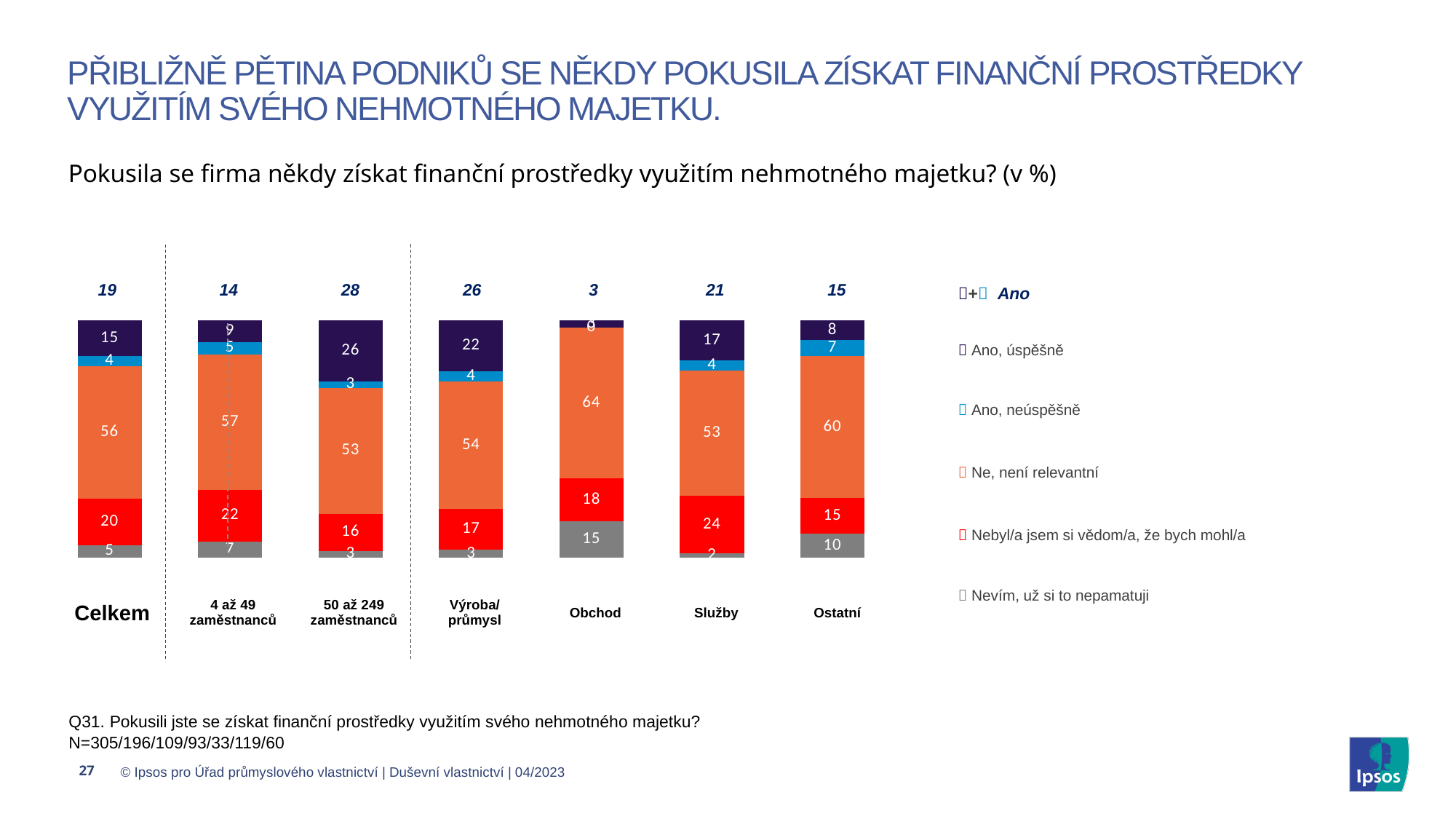
Which colour represents 'Ne, není relevantní' in the chart? orange What is the combined 'Ano' value shown above the Obchod bar? 3 Which category has the highest combined 'Ano' value shown above the bars? 50 až 249 zaměstnanců Which has a larger 'Nebyl/a jsem si vědom/a, že bych mohl/a' value: Služby or Ostatní? Služby What kind of chart is shown on the slide? stacked bar chart What is the value of 'Nevím, už si to nepamatuji' for Ostatní? 10 What is the value of 'Ano, úspěšně' for 50 až 249 zaměstnanců? 26 What is the value of 'Ne, není relevantní' for Celkem? 56 What is the difference between the 'Ne, není relevantní' values for Obchod and Celkem? 8 How many response categories does the legend list (excluding the combined 'Ano' line)? 5 How many categories (bars) are shown in the chart? 7 Which category has the lowest combined 'Ano' value shown above the bars? Obchod